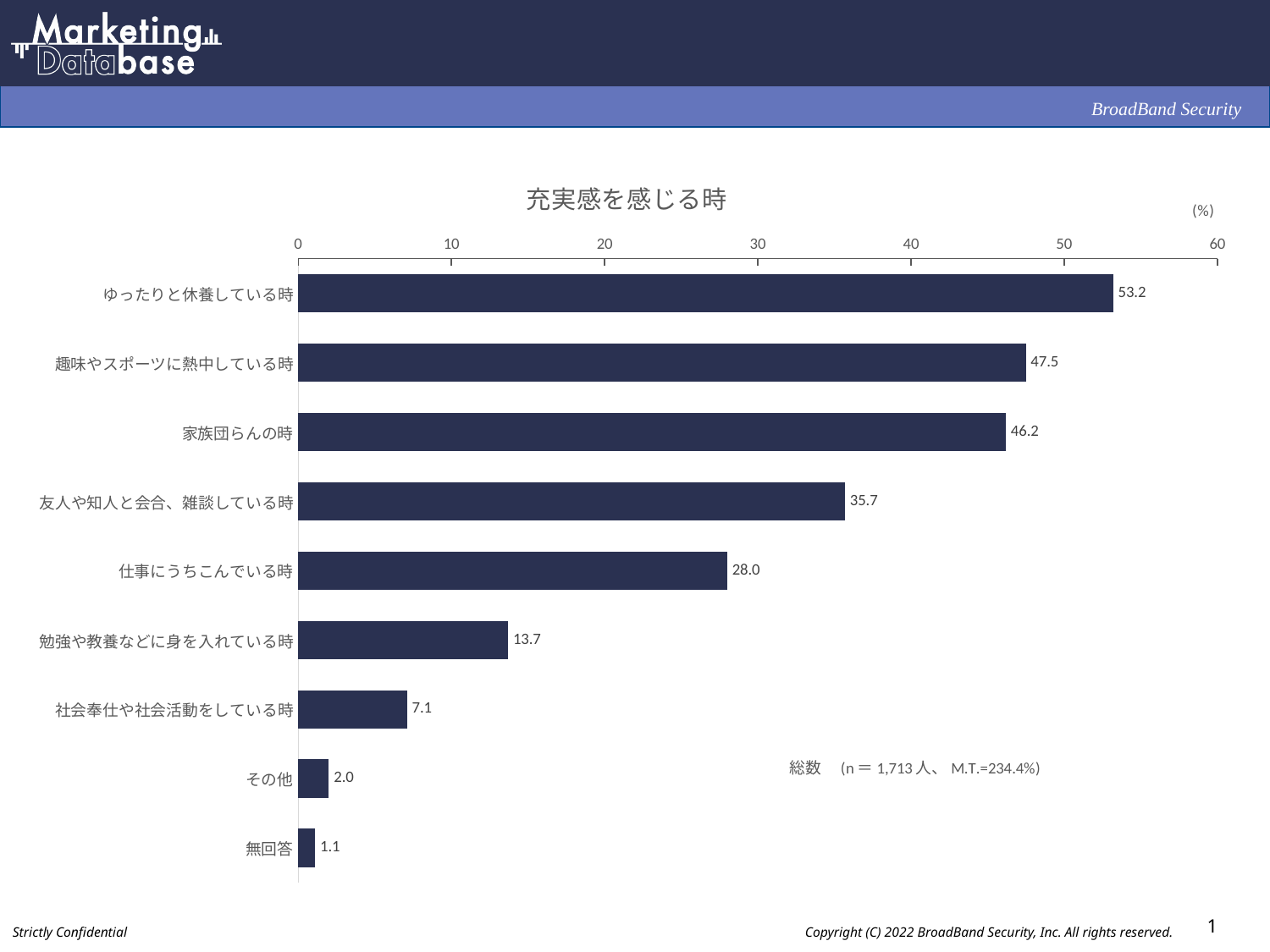
What is the difference between the values for 趣味やスポーツに熱中している時 and 家族団らんの時? 1.3 What kind of chart is shown on the slide? bar chart What is the title of the chart? 充実感を感じる時 What is the value for ゆったりと休養している時? 53.2 Is the value for 家族団らんの時 greater or less than 40? greater What is the value for 仕事にうちこんでいる時? 28.0 What is the value for 社会奉仕や社会活動をしている時? 7.1 How many categories are shown in the chart? 9 What is the difference between the values for 友人や知人と会合、雑談している時 and 仕事にうちこんでいる時? 7.7 Which is larger, the value for 勉強や教養などに身を入れている時 or the value for 社会奉仕や社会活動をしている時? 勉強や教養などに身を入れている時 Which category has the lowest value? 無回答 Which category has the highest value? ゆったりと休養している時